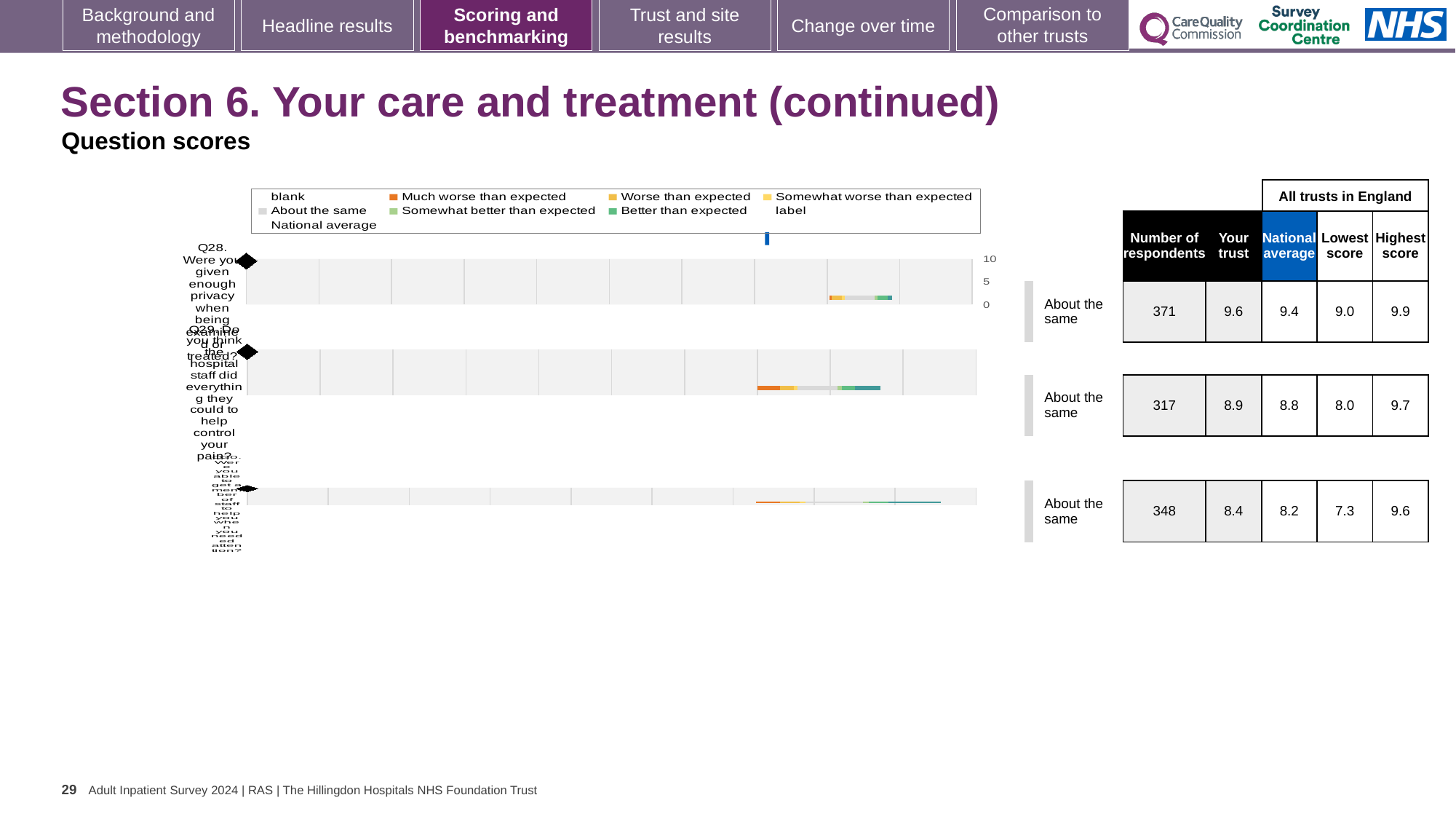
What benchmark category is shown next to the Q30 chart? About the same What is the highest value shown on the score axis of the charts? 10 For Q28 (privacy when being examined or treated), what is the 'Your trust' score shown? 9.6 What colour does the legend use for 'Much worse than expected'? orange Which question has the highest 'Your trust' score on the slide? Q28 Which question has the lowest 'Lowest score' value among all trusts in England? Q30 How many questions (Q28, Q29, Q30) are plotted on the slide? 3 For Q29 (staff did everything to help control your pain), what is the national average score shown? 8.8 What kind of chart is used to show the question scores on this slide? bar chart For Q29, which is larger: the 'Your trust' score or the national average? Your trust How many respondents are shown for Q30, the third question on the slide? 348 For Q28, what is the difference between the 'Your trust' score and the national average? 0.2